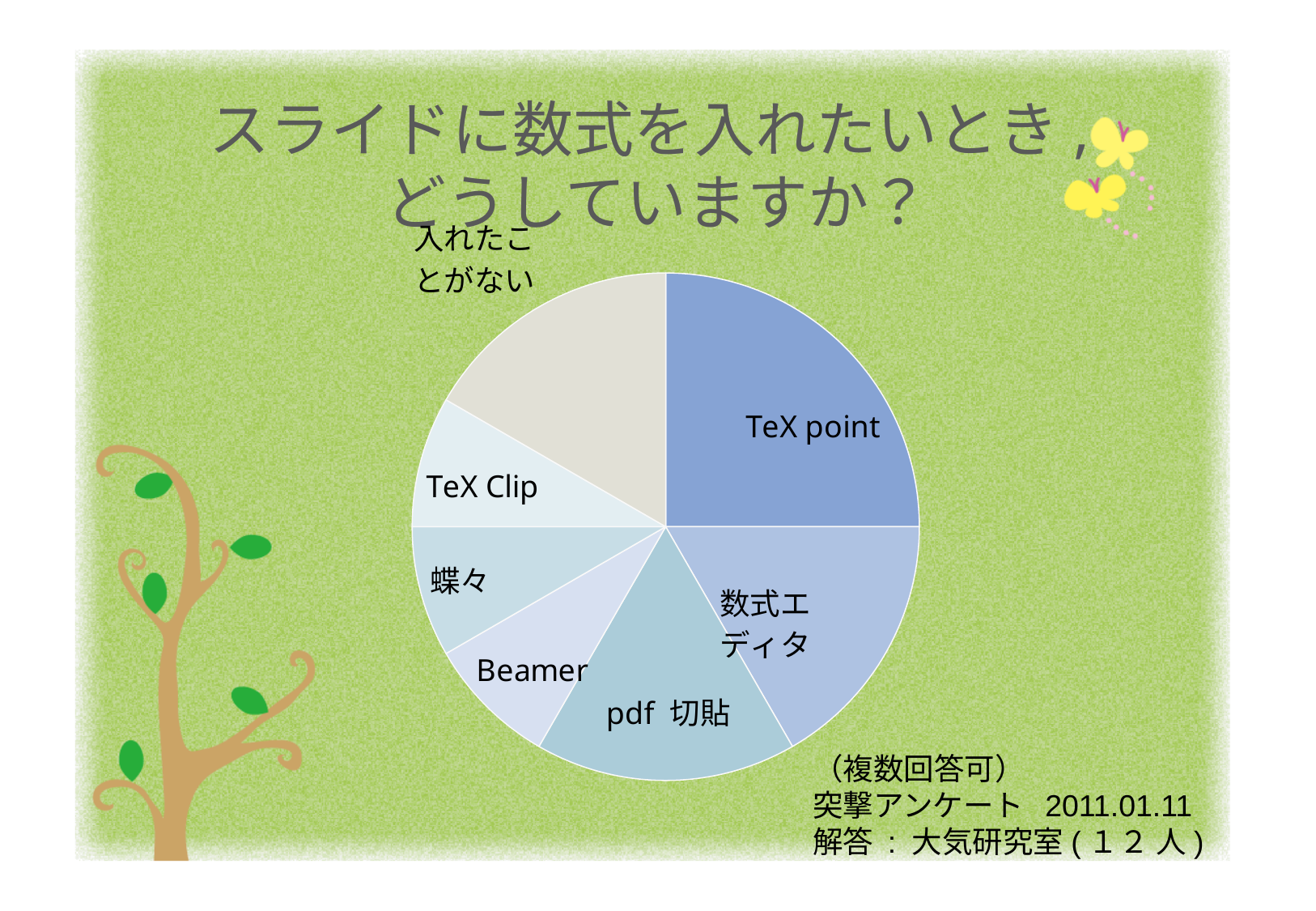
Which is larger in the pie chart, the TeX point slice or the Beamer slice? TeX point Which is larger in the pie chart, the 入れたことがない slice or the Beamer slice? 入れたことがない Which is larger in the pie chart, the 数式エディタ slice or the 蝶々 slice? 数式エディタ What kind of chart is shown on the slide? pie chart How many slices does the pie chart have? 7 What is the title of the slide containing the pie chart? スライドに数式を入れたいとき, どうしていますか？ Which slice of the pie chart is the largest? TeX point Which slice of the pie chart is labelled with a grey/beige colour at the top left? 入れたことがない